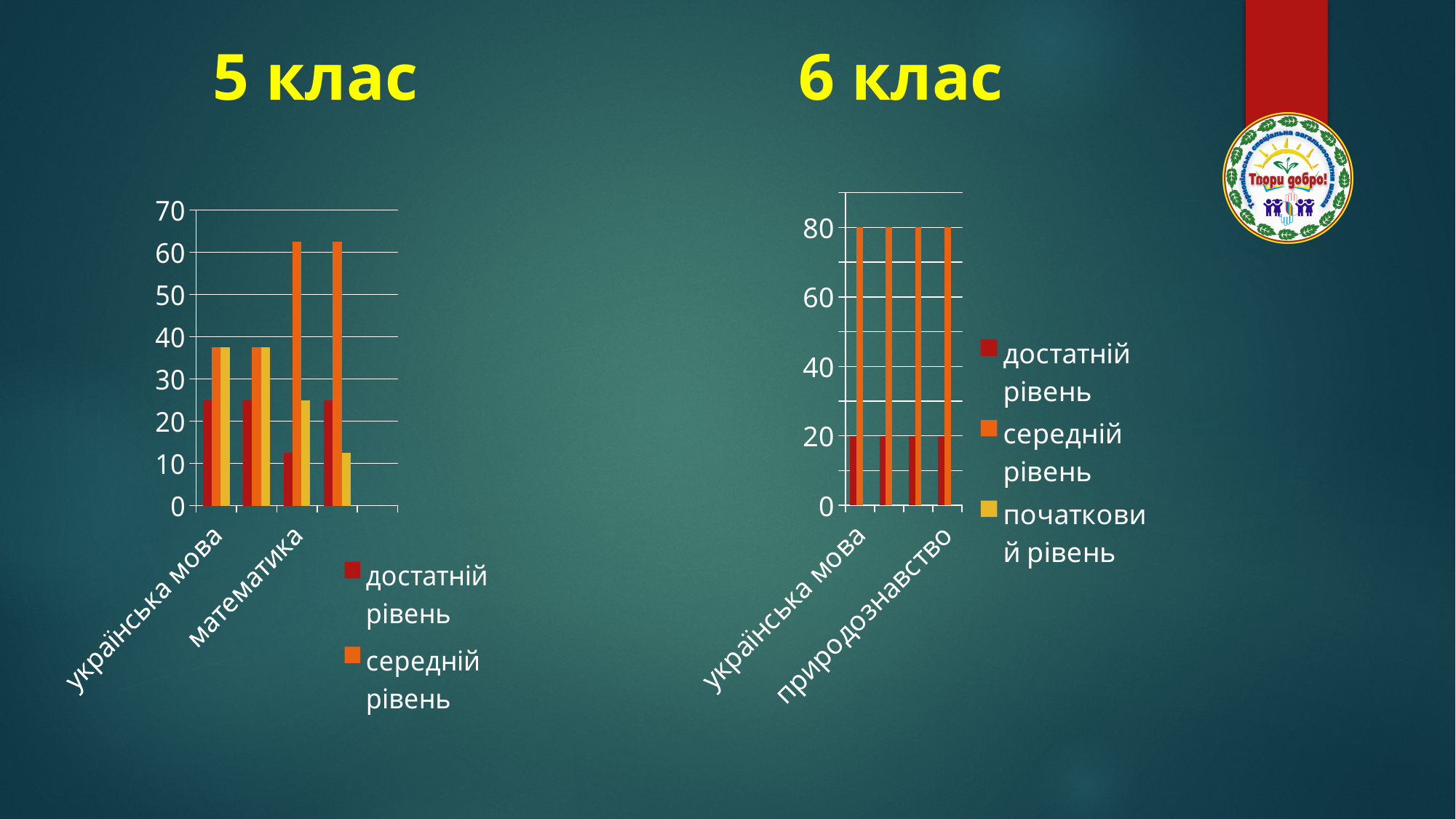
In the "6 клас" chart, which is larger for природознавство: достатній рівень or середній рівень? середній рівень How many series does the legend of the "6 клас" chart on the right list? 3 In the "6 клас" chart, is the value of достатній рівень for природознавство greater or less than 40? less In the "5 клас" chart, is the value of достатній рівень for українська мова greater or less than 30? less In the "6 клас" chart, what is the value of достатній рівень for українська мова? 20 In the "5 клас" chart, is the value of середній рівень for математика greater or less than 30? greater What is the title above the chart on the right side of the slide? 6 клас In the "6 клас" chart, what is the value of середній рівень for українська мова? 80 In the "6 клас" chart, what is the value of середній рівень for природознавство? 80 In the "6 клас" chart, what is the difference between середній рівень and достатній рівень for українська мова? 60 In the "6 клас" chart, which series has the highest value for українська мова? середній рівень What kind of chart is the "5 клас" chart on the left? bar chart